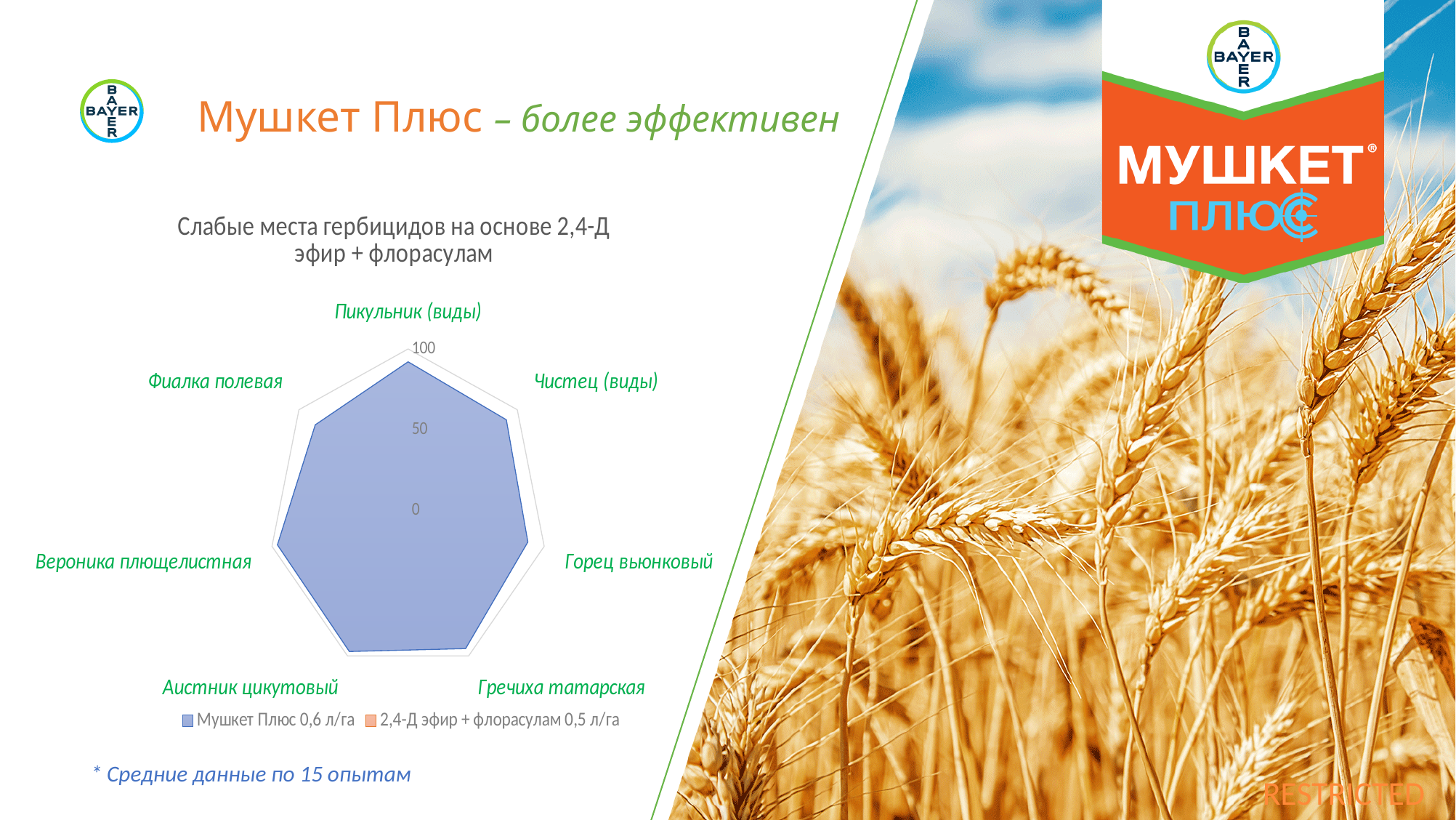
How many weed categories are plotted on the radar chart? 7 Is the value for Мушкет Плюс 0,6 л/га on Аистник цикутовый greater or less than 50? greater What kind of chart is shown on the slide? Radar chart What is the maximum value shown on the chart's axis scale? 100 Is the value for Мушкет Плюс 0,6 л/га on Фиалка полевая greater or less than 50? greater What colour is used for the Мушкет Плюс 0,6 л/га series in the chart? Blue How many series does the chart legend list? 2 What is the title of the chart? Слабые места гербицидов на основе 2,4-Д эфир + флорасулам Is the value for Мушкет Плюс 0,6 л/га on Горец вьюнковый greater or less than 50? greater